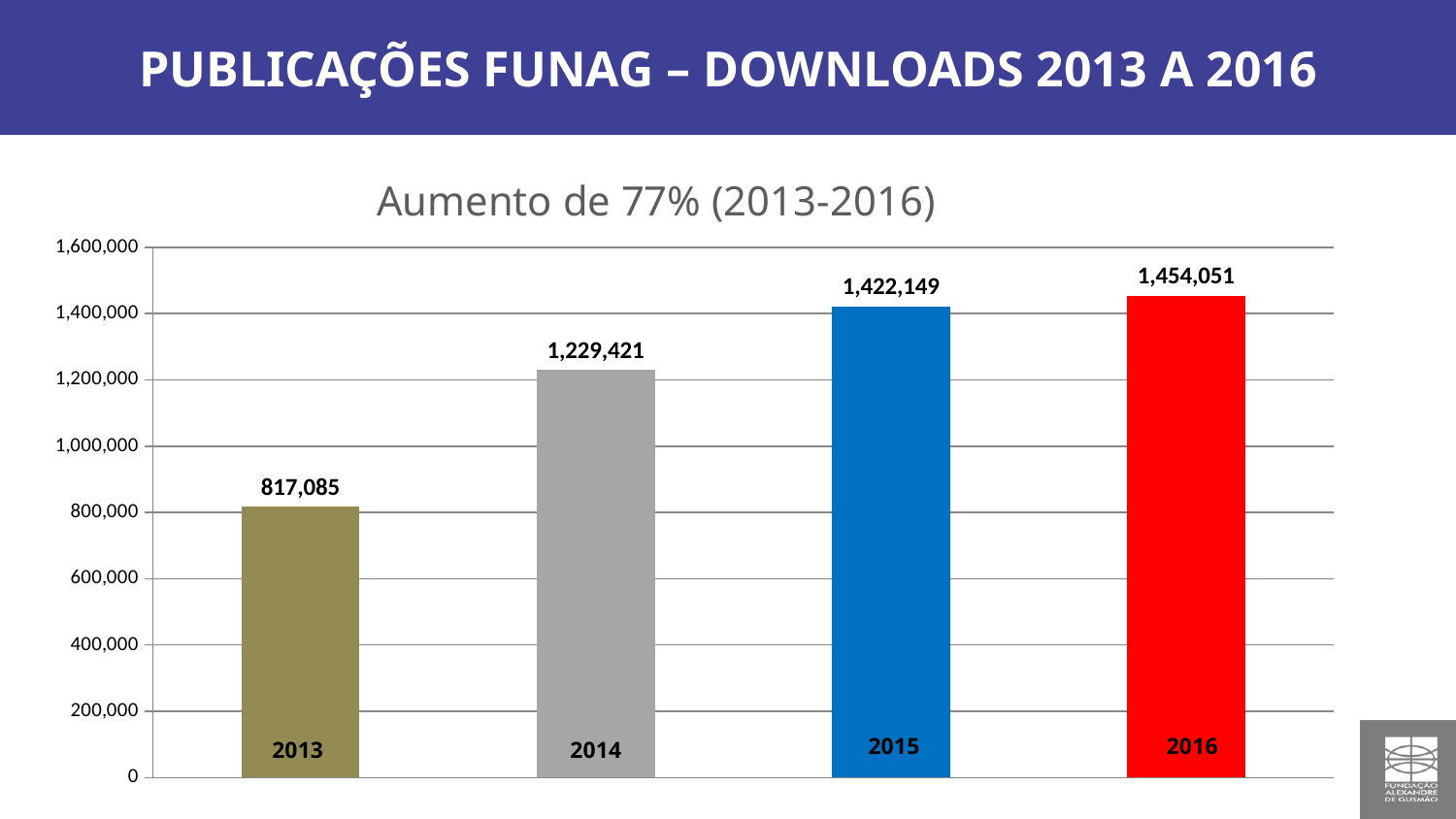
Which year has the highest number of downloads? 2016 Do the download values rise or fall from 2013 to 2016? Rise What is the number of downloads shown for 2016? 1,454,051 Which year had more downloads, 2015 or 2016? 2016 How many years are shown on the chart? 4 What is the difference in downloads between 2016 and 2013? 636,966 Which year has the lowest number of downloads? 2013 Is the value for 2014 greater or less than 1,000,000? greater What kind of chart is shown on the slide? Bar chart What is the difference in downloads between 2014 and 2013? 412,336 What is the number of downloads shown for 2014? 1,229,421 What is the number of downloads shown for 2013? 817,085